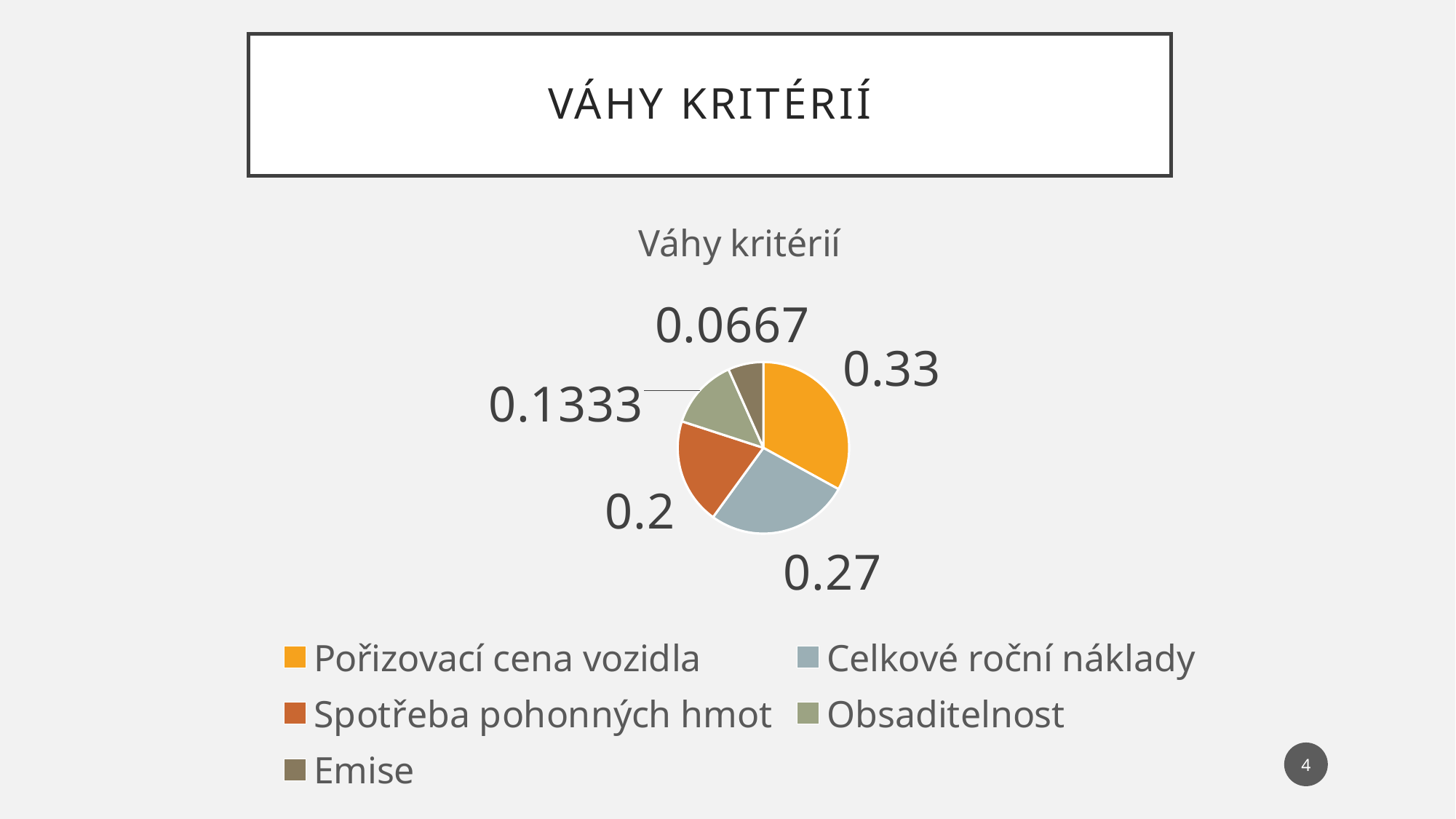
What is the title of the chart? Váhy kritérií Which category has the smallest slice? Emise What is the value for Celkové roční náklady? 0.27 What is the value for Emise? 0.0667 What is the difference between the values for Pořizovací cena vozidla and Celkové roční náklady? 0.06 What is the value for Obsaditelnost? 0.1333 What type of chart is shown on the slide? pie chart Which category has the largest slice? Pořizovací cena vozidla How many categories does the pie chart have? 5 Which is larger, the value for Spotřeba pohonných hmot or the value for Obsaditelnost? Spotřeba pohonných hmot What is the value for Spotřeba pohonných hmot? 0.2 What is the value for Pořizovací cena vozidla? 0.33